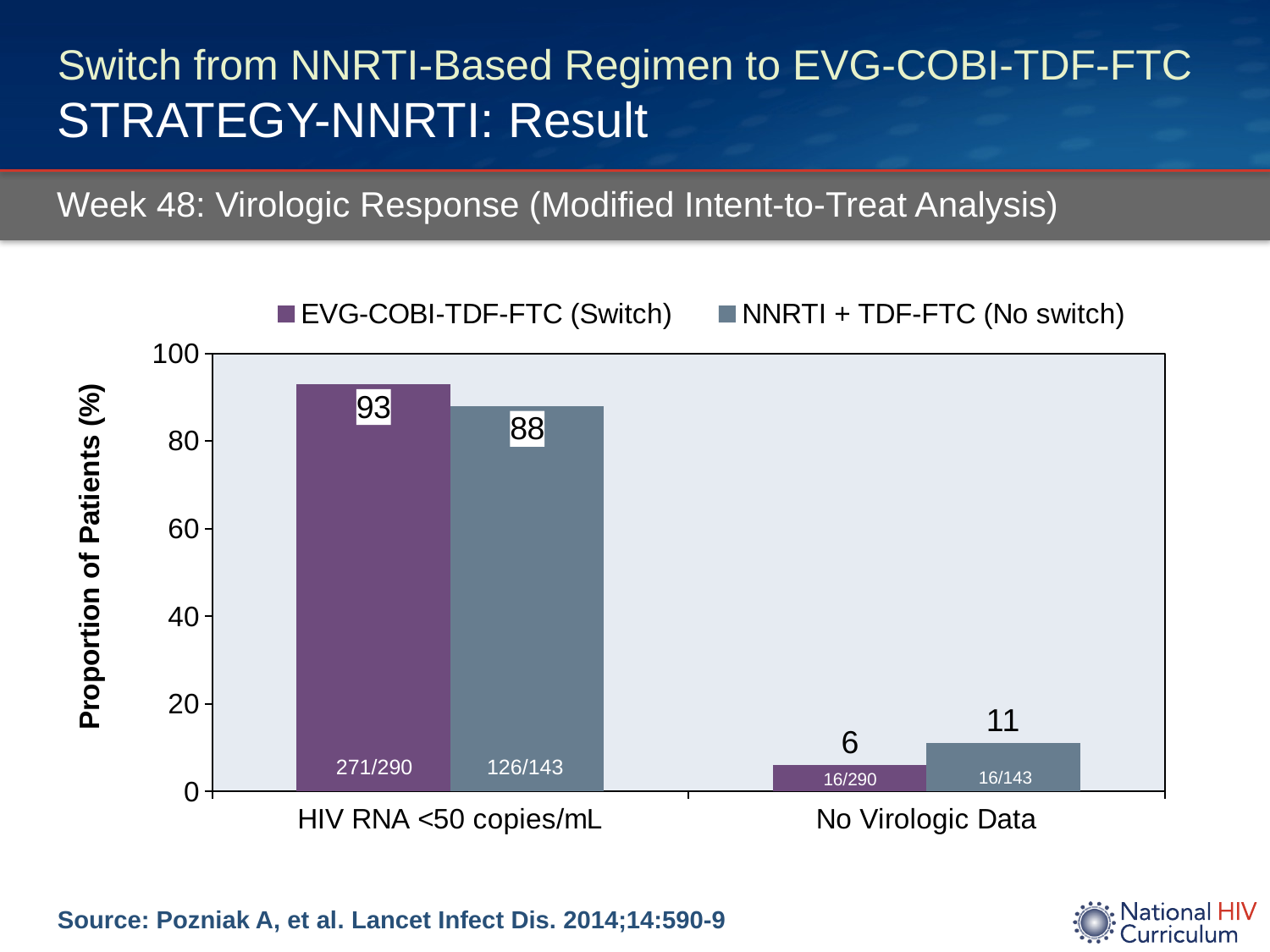
What is the patient fraction shown for the NNRTI + TDF-FTC (No switch) group with No Virologic Data? 16/143 What percentage of patients in the NNRTI + TDF-FTC (No switch) group had HIV RNA <50 copies/mL? 88 Which group had the higher proportion of patients with HIV RNA <50 copies/mL? EVG-COBI-TDF-FTC (Switch) What type of chart is shown on the slide? Bar chart What percentage of patients in the EVG-COBI-TDF-FTC (Switch) group had HIV RNA <50 copies/mL? 93 What percentage of patients in the NNRTI + TDF-FTC (No switch) group had No Virologic Data? 11 What is the patient fraction shown for the EVG-COBI-TDF-FTC (Switch) group with HIV RNA <50 copies/mL? 271/290 What percentage of patients in the EVG-COBI-TDF-FTC (Switch) group had No Virologic Data? 6 What is the difference in percentage points between the two groups for HIV RNA <50 copies/mL? 5 How many series does the legend list? 2 Which group had the higher proportion of patients with No Virologic Data? NNRTI + TDF-FTC (No switch) What is the label of the y-axis? Proportion of Patients (%)